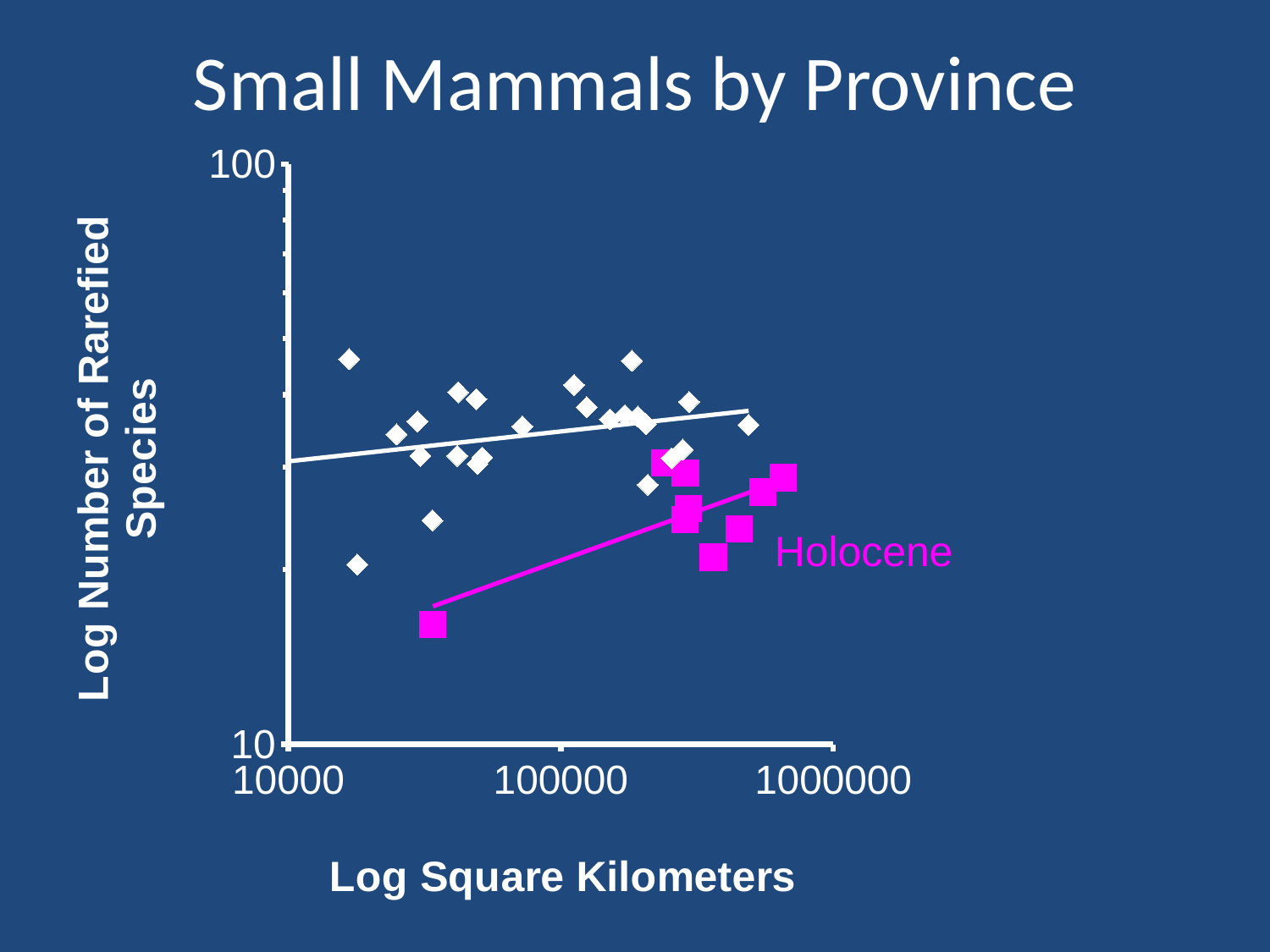
Is the highest white diamond point greater or less than 10 on the y axis? greater Is the lowest Holocene point located at an x value greater or less than 100000? less What kind of chart is shown on the slide? Scatter plot Is the lowest Holocene point greater or less than 100 on the y axis? less How many data series are plotted on the chart? 2 Do the Holocene values rise or fall as Log Square Kilometers increases? Rise Which series has the higher values overall, the white diamonds or the Holocene squares? White diamonds What is the title of the chart? Small Mammals by Province What is the label of the x axis? Log Square Kilometers